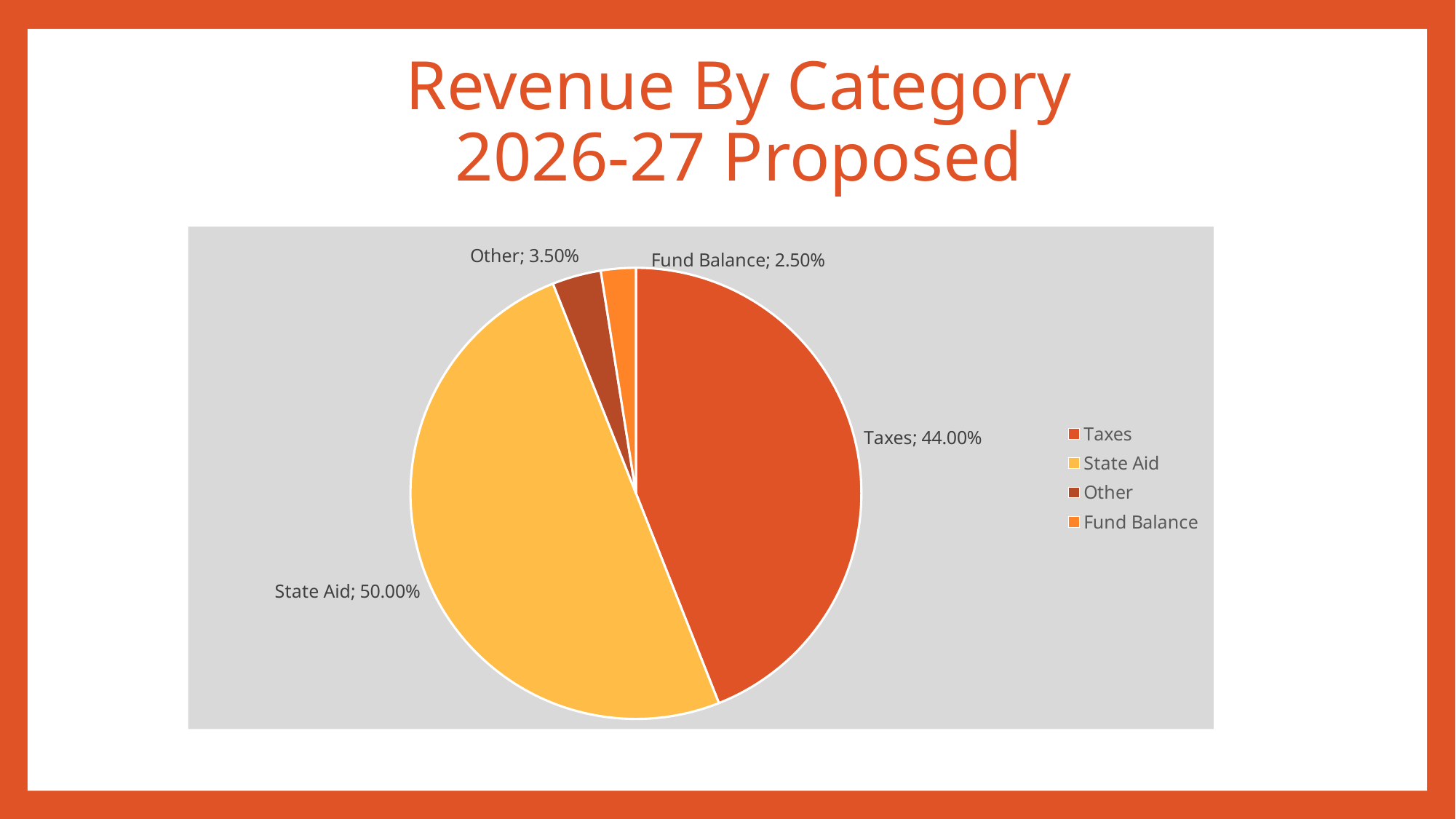
What share of revenue comes from State Aid? 50.00% What is the combined share of Other and Fund Balance? 6.00% What share of revenue comes from Fund Balance? 2.50% How many categories are shown in the pie chart? 4 What is the title of the slide? Revenue By Category 2026-27 Proposed What share of revenue comes from Taxes? 44.00% What share of revenue comes from Other? 3.50% Which is larger, the share for Other or the share for Fund Balance? Other Which category has the smallest share of revenue? Fund Balance Which category has the largest share of revenue? State Aid What kind of chart is shown on the slide? Pie chart What is the difference in percentage points between State Aid and Taxes? 6.00%